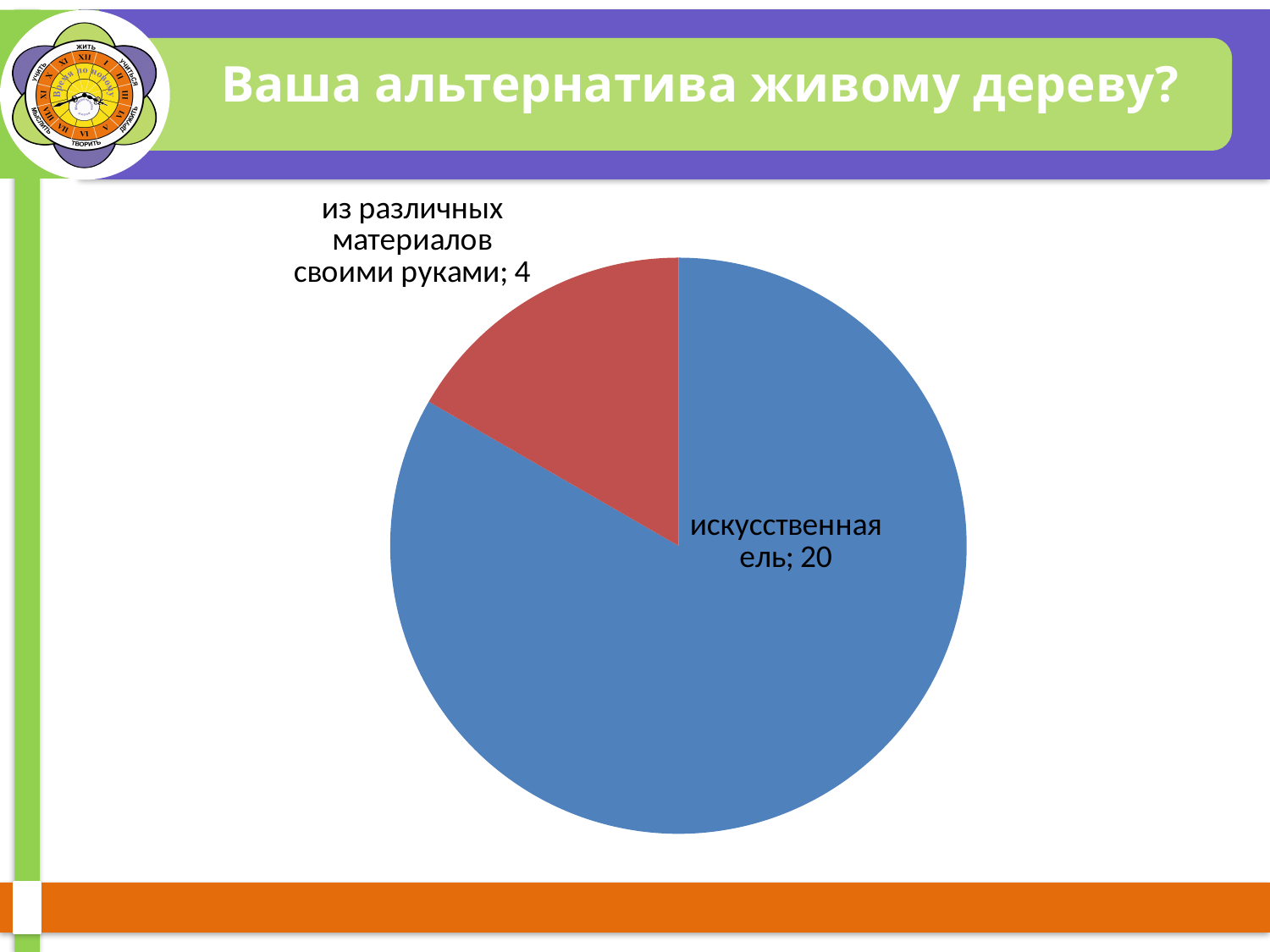
What is the total of all slices in the pie chart? 24 Which category has the smallest slice? из различных материалов своими руками How many slices does the pie chart have? 2 What kind of chart is shown on the slide? pie chart Which category has the largest slice? искусственная ель What colour is the slice for "искусственная ель"? blue What is the value for "из различных материалов своими руками"? 4 What is the difference between the values for "искусственная ель" and "из различных материалов своими руками"? 16 What is the title of the slide containing the chart? Ваша альтернатива живому дереву? What is the value for "искусственная ель"? 20 Which is larger: the value for "искусственная ель" or for "из различных материалов своими руками"? искусственная ель What share of the pie does "из различных материалов своими руками" represent? 1/6